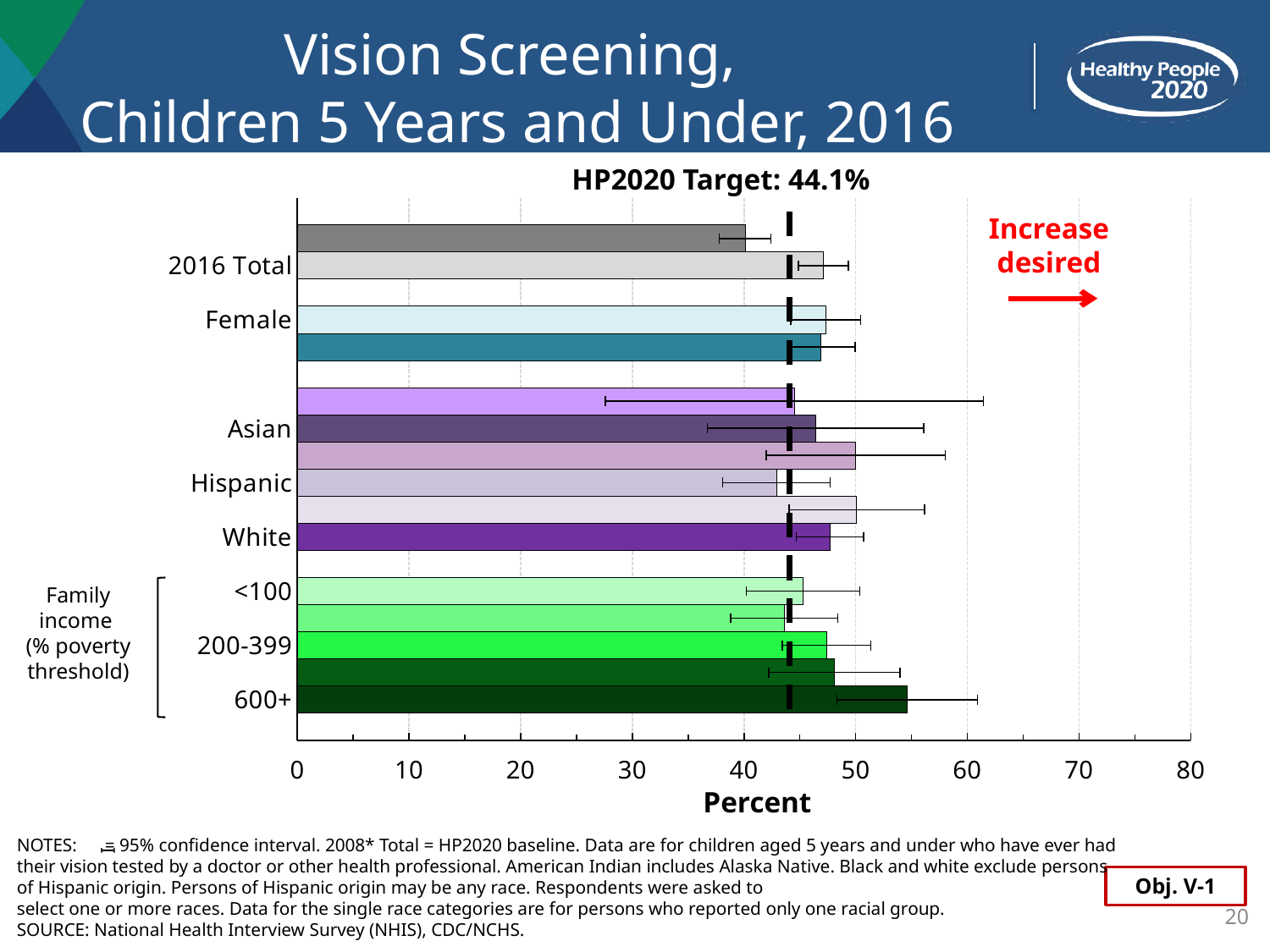
Is the value for 2016 Total greater or less than 40? greater What is the HP2020 Target value shown above the chart? 44.1% Which has the larger value, 600+ family income or White? 600+ Which has the larger value, 600+ family income or Hispanic? 600+ Is the value for <100 family income greater or less than 60? less Among the labeled categories, which has the highest value? 600+ What is the label of the horizontal axis? Percent What kind of chart is shown on the slide? bar chart Is the value for Hispanic greater or less than 50? less